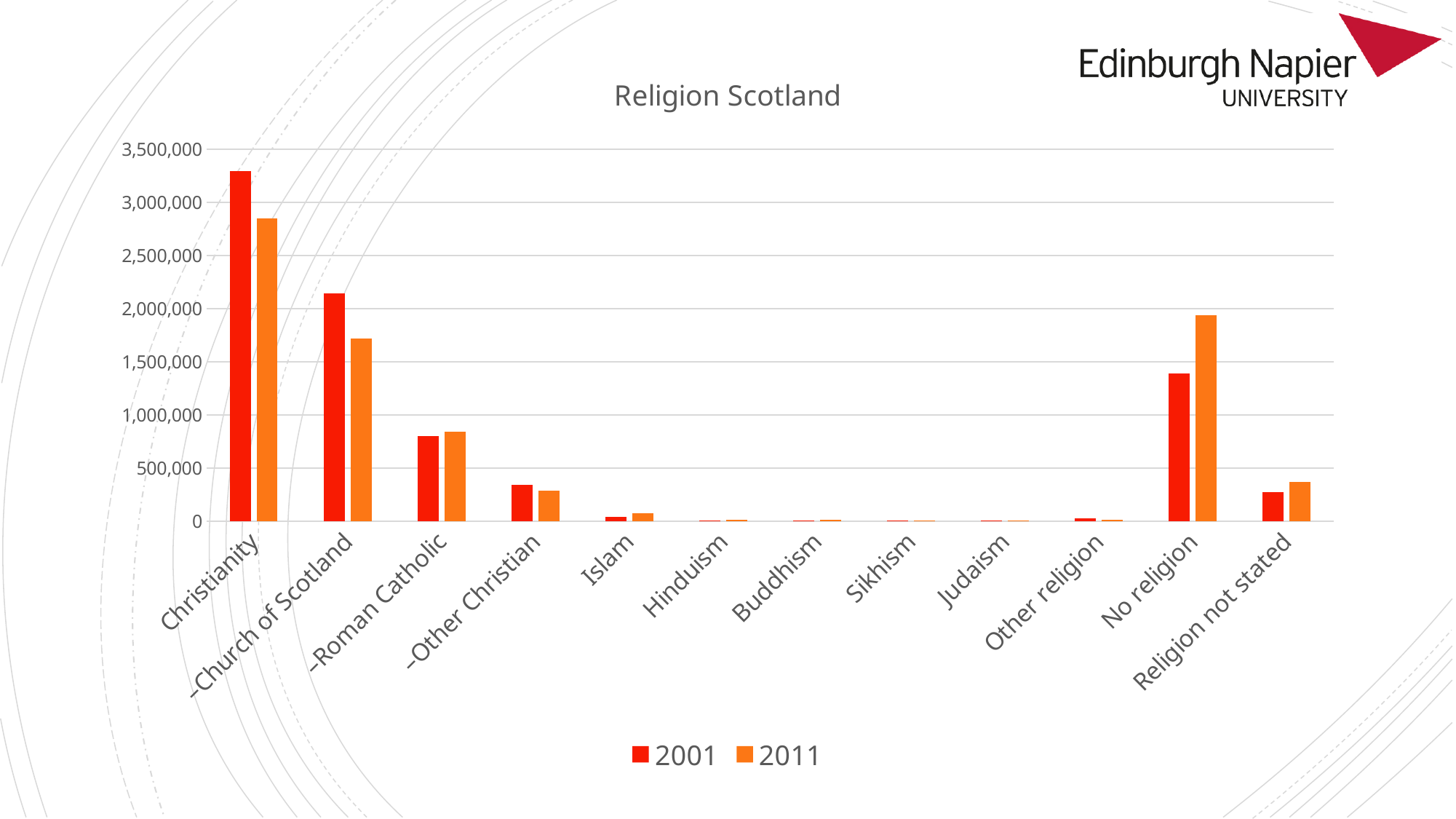
Is the 2001 value for No religion greater or less than 1,500,000? less What is the title of the chart? Religion Scotland How many series does the legend list? 2 Is the 2001 value for Christianity greater or less than 3,000,000? greater Which category has the highest value for 2011? Christianity For Church of Scotland, which year has the larger value, 2001 or 2011? 2001 How many categories are shown on the x axis? 12 Is the 2011 value for Christianity greater or less than 3,000,000? less What kind of chart is shown on the slide? bar chart Which category has the highest value for 2001? Christianity For No religion, which year has the larger value, 2001 or 2011? 2011